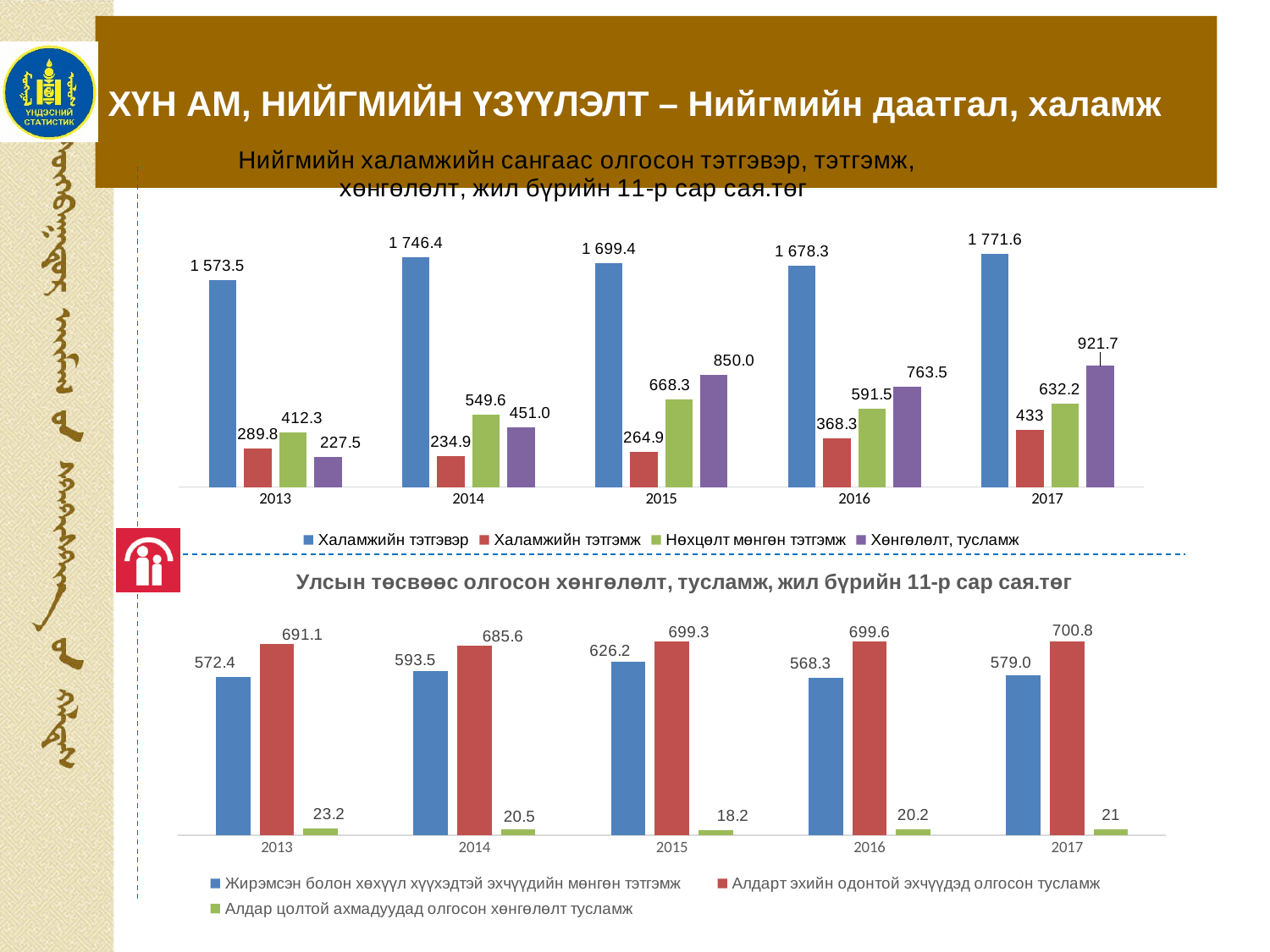
In the top chart (Нийгмийн халамжийн сангаас олгосон тэтгэвэр, тэтгэмж, хөнгөлөлт), what is the value of Халамжийн тэтгэвэр in 2014? 1 746.4 In the top chart, which year has the lowest value for Хөнгөлөлт, тусламж? 2013 In the top chart, which year has the highest value for Халамжийн тэтгэвэр? 2017 In the top chart, how many series does the legend list? 4 In the bottom chart, how many years are shown on the x axis? 5 In the top chart, what is the difference between Нөхцөлт мөнгөн тэтгэмж in 2015 and in 2014? 118.7 In the bottom chart, which year has the lowest value for Алдар цолтой ахмадуудад олгосон хөнгөлөлт тусламж? 2015 What type of chart is the bottom chart? bar chart In the bottom chart (Улсын төсвөөс олгосон хөнгөлөлт, тусламж), what is the value of Алдарт эхийн одонтой эхчүүдэд олгосон тусламж in 2017? 700.8 In the top chart, does Халамжийн тэтгэмж rise or fall from 2016 to 2017? rise In the bottom chart, which is larger in 2015: Жирэмсэн болон хөхүүл хүүхэдтэй эхчүүдийн мөнгөн тэтгэмж or Алдарт эхийн одонтой эхчүүдэд олгосон тусламж? Алдарт эхийн одонтой эхчүүдэд олгосон тусламж In the top chart, what is the value of Хөнгөлөлт, тусламж in 2017? 921.7